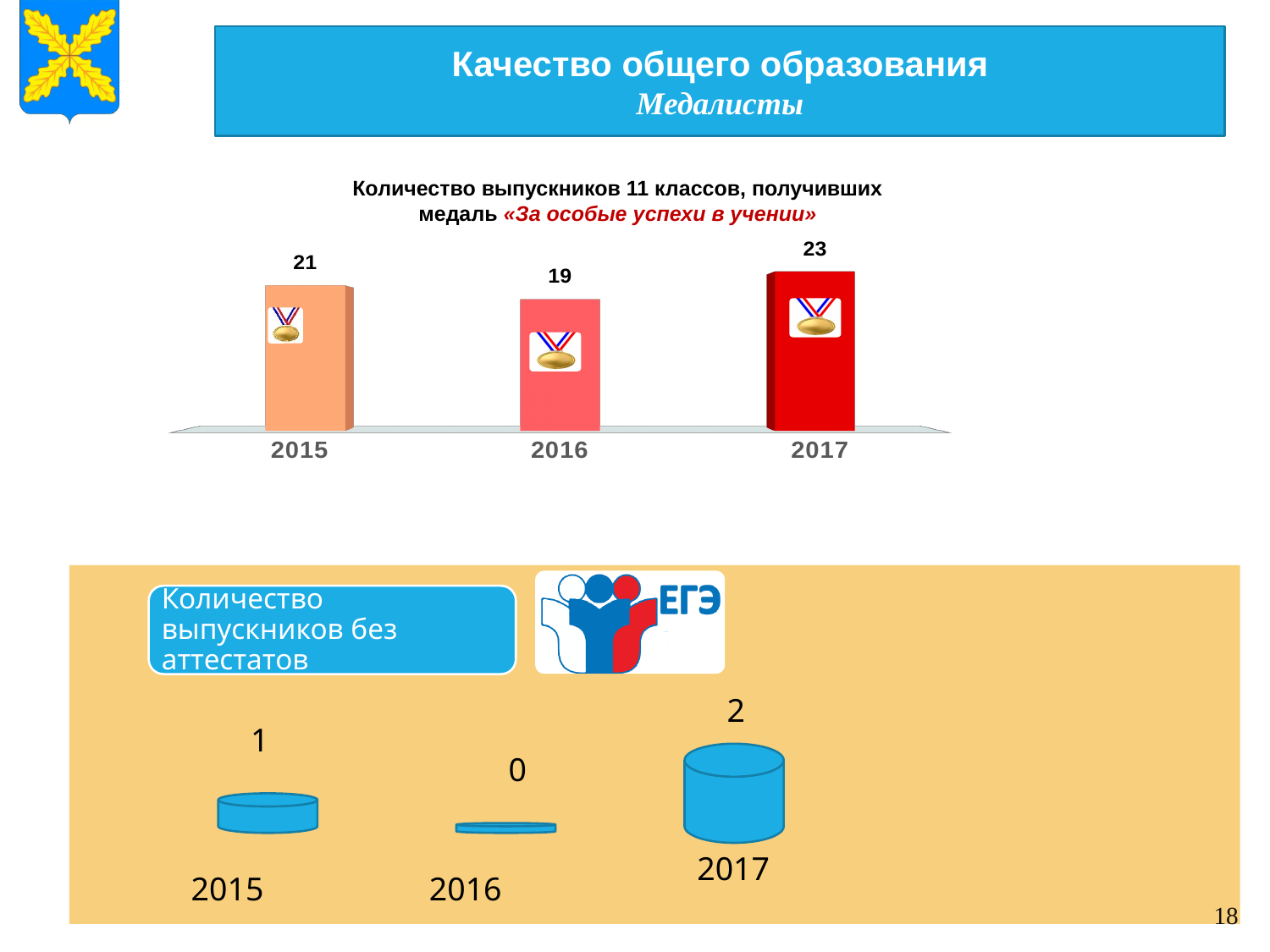
In the bottom chart (graduates without certificates), what is the value for 2016? 0 In the top chart (medalists), what is the difference between the values for 2017 and 2016? 4 In the top chart (medalists), which year has the lowest number of medalists? 2016 In the top chart (medalists), what is the value for 2017? 23 How many years are shown in the top chart (medalists)? 3 In the top chart (medalists), what is the value for 2016? 19 In the top chart (medalists), how many 11th-grade graduates received the medal in 2015? 21 In the bottom chart (graduates without certificates), what is the difference between the values for 2017 and 2015? 1 In the top chart (medalists), which is larger, the value for 2015 or the value for 2016? 2015 In the bottom chart (graduates without certificates), which year has the highest value? 2017 In the top chart (medalists), which year has the highest number of medalists? 2017 What kind of chart is the top chart (medalists)? bar chart